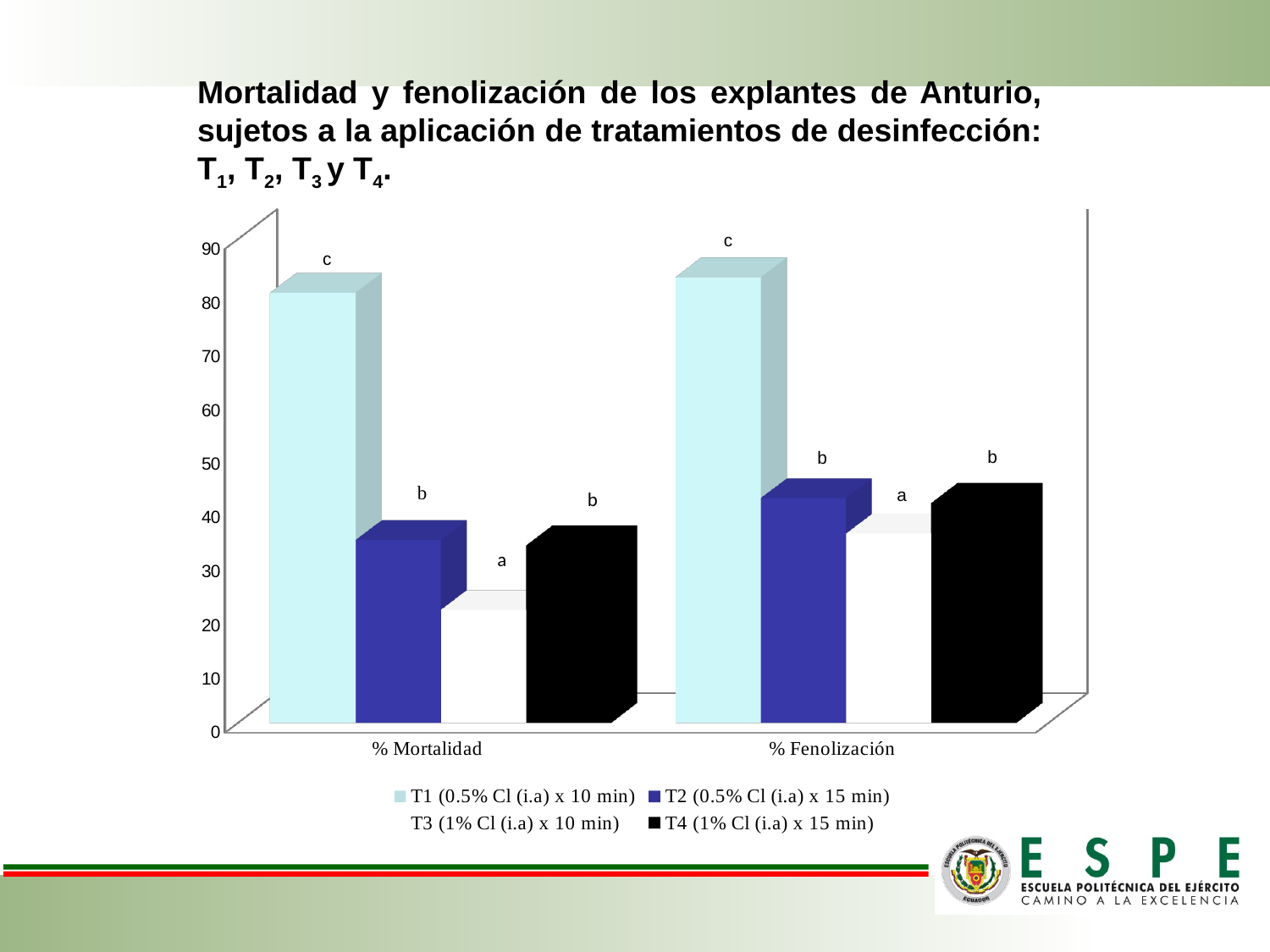
Is the value for T4 in % Fenolización greater or less than 60? less How many series does the legend list? 4 Which treatment has the lowest value for % Fenolización? T3 (1% Cl (i.a) x 10 min) What are the two category labels on the x axis? % Mortalidad and % Fenolización How many categories are shown on the x axis? 2 Which treatment has the highest value for % Fenolización? T1 (0.5% Cl (i.a) x 10 min) Which treatment has the highest value for % Mortalidad? T1 (0.5% Cl (i.a) x 10 min) What kind of chart is shown on the slide? bar chart Which is larger for % Mortalidad, the value for T1 or the value for T2? T1 Which treatment has the lowest value for % Mortalidad? T3 (1% Cl (i.a) x 10 min) Is the value for T1 in % Mortalidad greater or less than 70? greater Is the value for T3 in % Mortalidad greater or less than 30? less